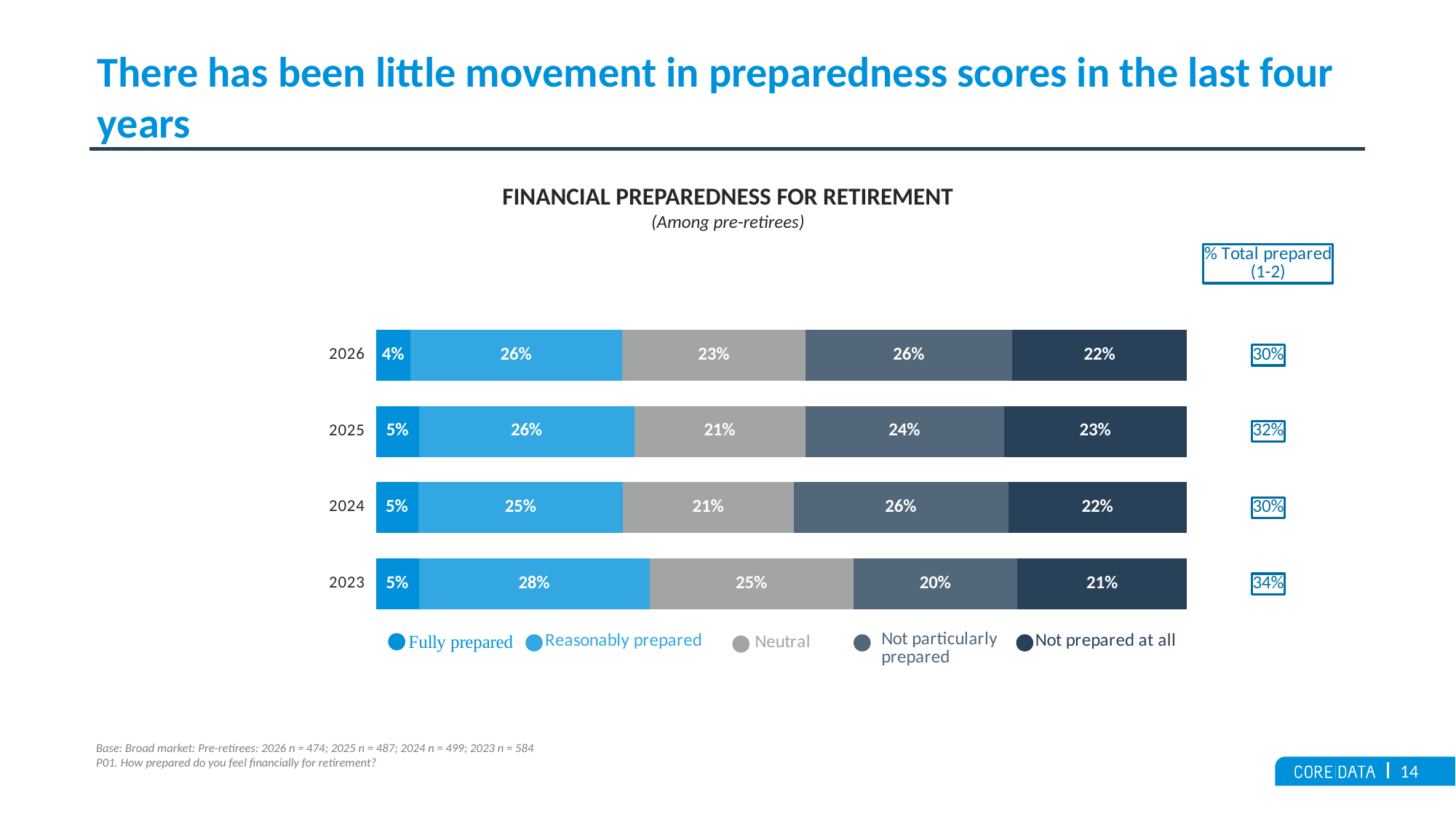
Which year has the highest % Total prepared (1-2)? 2023 What percentage were Reasonably prepared in 2023? 28% What percentage of pre-retirees were Neutral in 2026? 23% Which year has the lowest Fully prepared percentage? 2026 Which year has the larger Not particularly prepared percentage, 2026 or 2023? 2026 Which year has the highest Reasonably prepared percentage? 2023 How many series does the legend list? 5 How many years are shown in the chart? 4 What is the % Total prepared (1-2) figure for 2023? 34% What is the difference in the Neutral percentage between 2023 and 2024? 4 percentage points What kind of chart is shown on the slide? Stacked bar chart What is the value for Not prepared at all in 2025? 23%